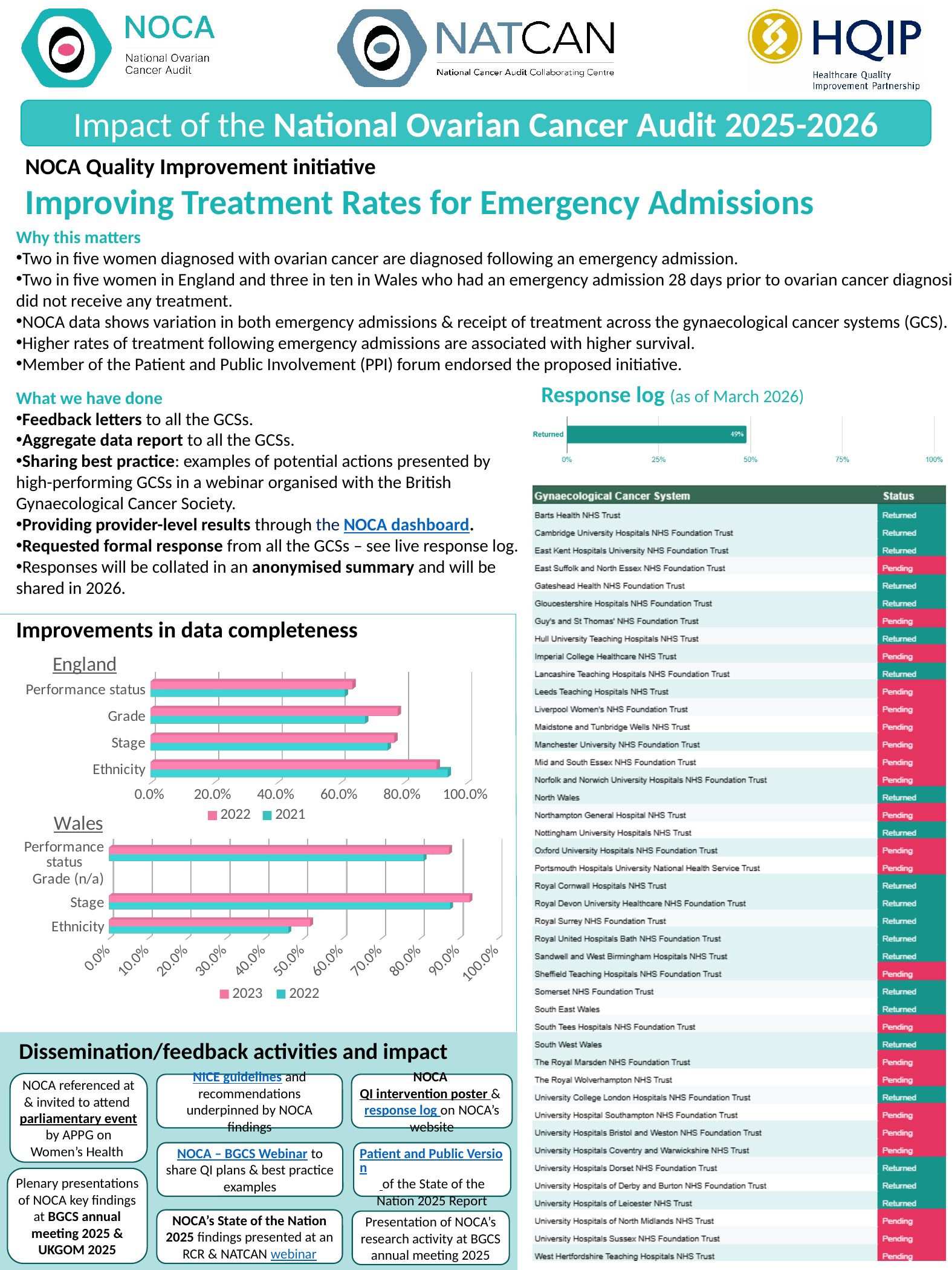
In the England data completeness chart, is the 2022 value for Grade greater or less than 60.0%? greater In the Wales data completeness chart, which category has the lowest value for 2023? Ethnicity What kind of chart is the Response log chart? bar chart In the Wales data completeness chart, is the 2023 value for Ethnicity greater or less than 70.0%? less In the England data completeness chart, how many categories are plotted? 4 What kind of chart is the Wales data completeness chart? bar chart In the Response log chart, what value is shown for Returned? 49% In the England data completeness chart, which category has the highest value for 2022? Ethnicity In the England data completeness chart, which category has the lowest value for 2022? Performance status In the Wales data completeness chart, which two years does the legend list? 2023 and 2022 In the England data completeness chart, how many series does the legend list? 2 In the England data completeness chart, for Grade, which series has the larger value, 2022 or 2021? 2022